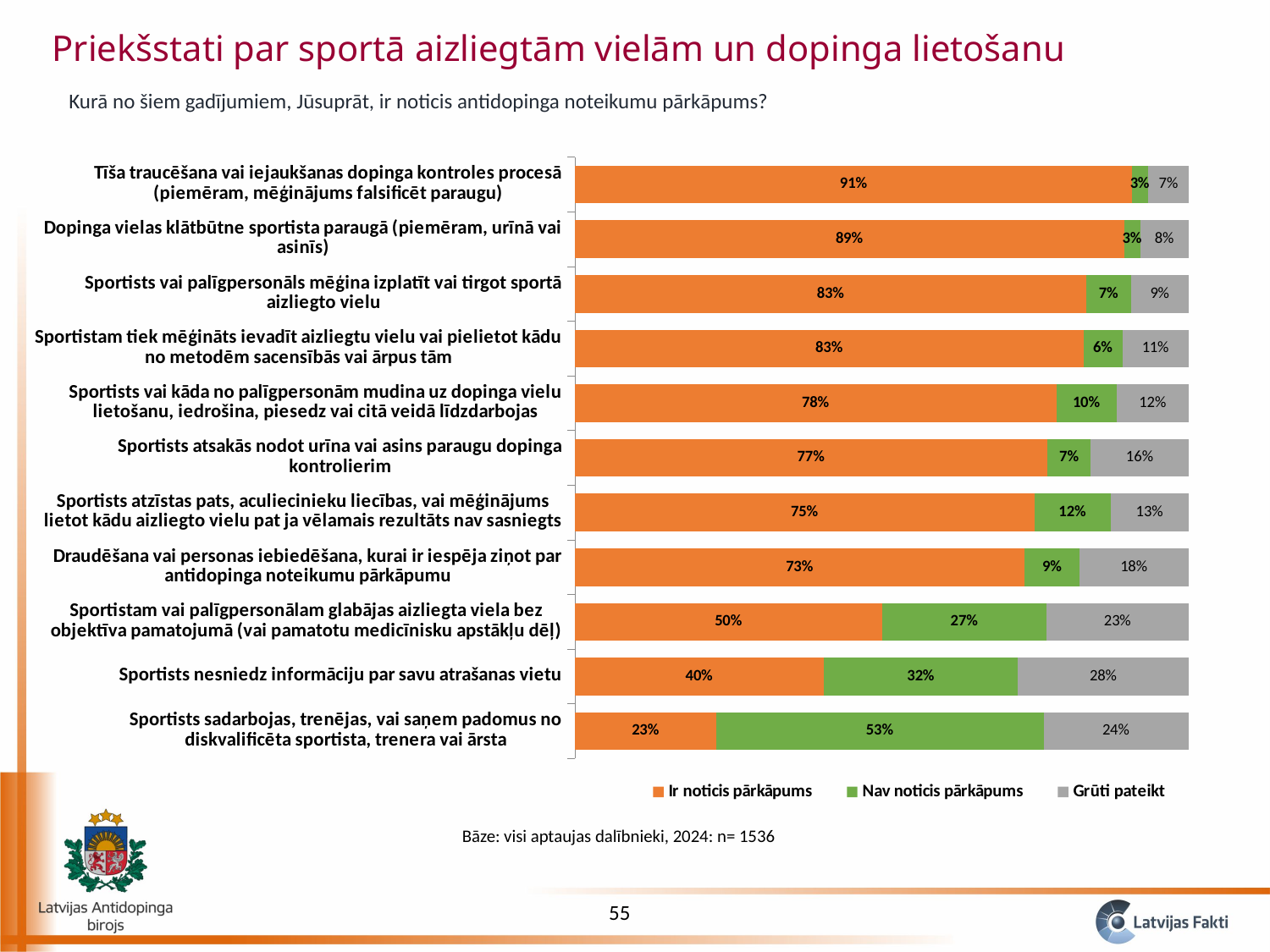
How many series does the legend list? 3 How many categories (statements) are shown in the chart? 11 Which statement has the highest 'Ir noticis pārkāpums' value? Tīša traucēšana vai iejaukšanas dopinga kontroles procesā (piemēram, mēģinājums falsificēt paraugu) What type of chart is shown on the slide? Stacked bar chart What is the total of the stacked bar for 'Sportists nesniedz informāciju par savu atrašanas vietu'? 100% What is the difference between the 'Ir noticis pārkāpums' values for 'Dopinga vielas klātbūtne sportista paraugā' and 'Sportistam vai palīgpersonālam glabājas aizliegta viela bez objektīva pamatojuma'? 39 percentage points What is the 'Ir noticis pārkāpums' value for 'Sportists nesniedz informāciju par savu atrašanas vietu'? 40% Which is larger: the 'Nav noticis pārkāpums' value for 'Sportists atzīstas pats, aculiecinieku liecības...' or for 'Sportists atsakās nodot urīna vai asins paraugu dopinga kontrolierim'? Sportists atzīstas pats, aculiecinieku liecības... Which statement has the lowest 'Ir noticis pārkāpums' value? Sportists sadarbojas, trenējas, vai saņem padomus no diskvalificēta sportista, trenera vai ārsta What is the 'Nav noticis pārkāpums' value for 'Sportists sadarbojas, trenējas, vai saņem padomus no diskvalificēta sportista, trenera vai ārsta'? 53% Which colour represents 'Grūti pateikt' in the chart? Grey What is the 'Grūti pateikt' value for 'Draudēšana vai personas iebiedēšana, kurai ir iespēja ziņot par antidopinga noteikumu pārkāpumu'? 18%